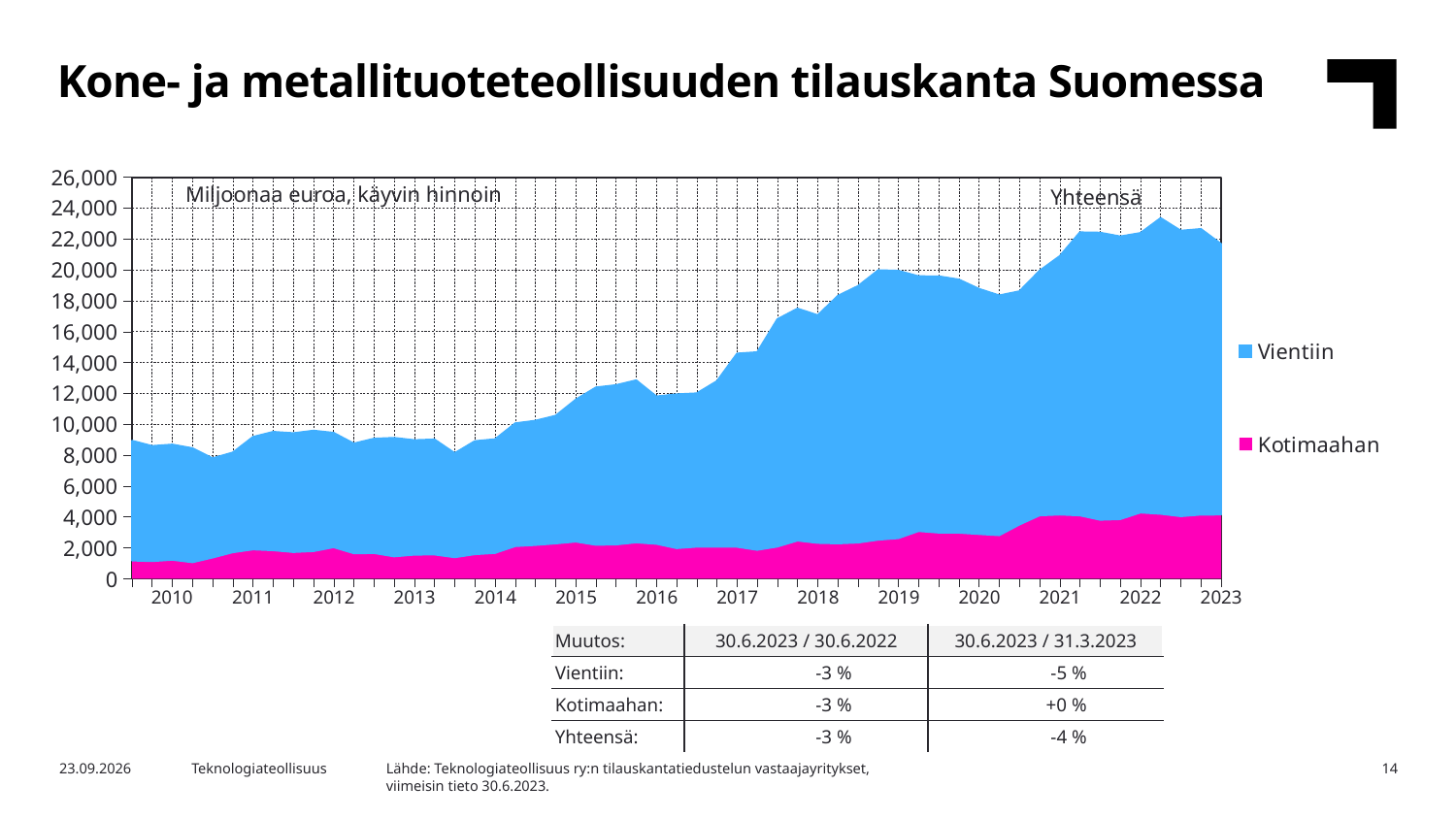
What are the two series named in the chart legend? Vientiin and Kotimaahan Which series is larger in 2023, Vientiin or Kotimaahan? Vientiin How many series does the chart legend list? 2 Is the Kotimaahan value in 2022 greater or less than 2,000? greater Is the total order backlog (Yhteensä) around 2018 greater or less than 16,000? greater What is the title of the slide containing the chart? Kone- ja metallituoteteollisuuden tilauskanta Suomessa How many year labels are shown on the x axis of the chart? 14 Is the total order backlog (Yhteensä) at the end of the series in 2023 greater or less than 20,000? greater What kind of chart is shown on the slide? Stacked area chart Does the total order backlog (Yhteensä) generally rise or fall from 2010 to 2023? rise